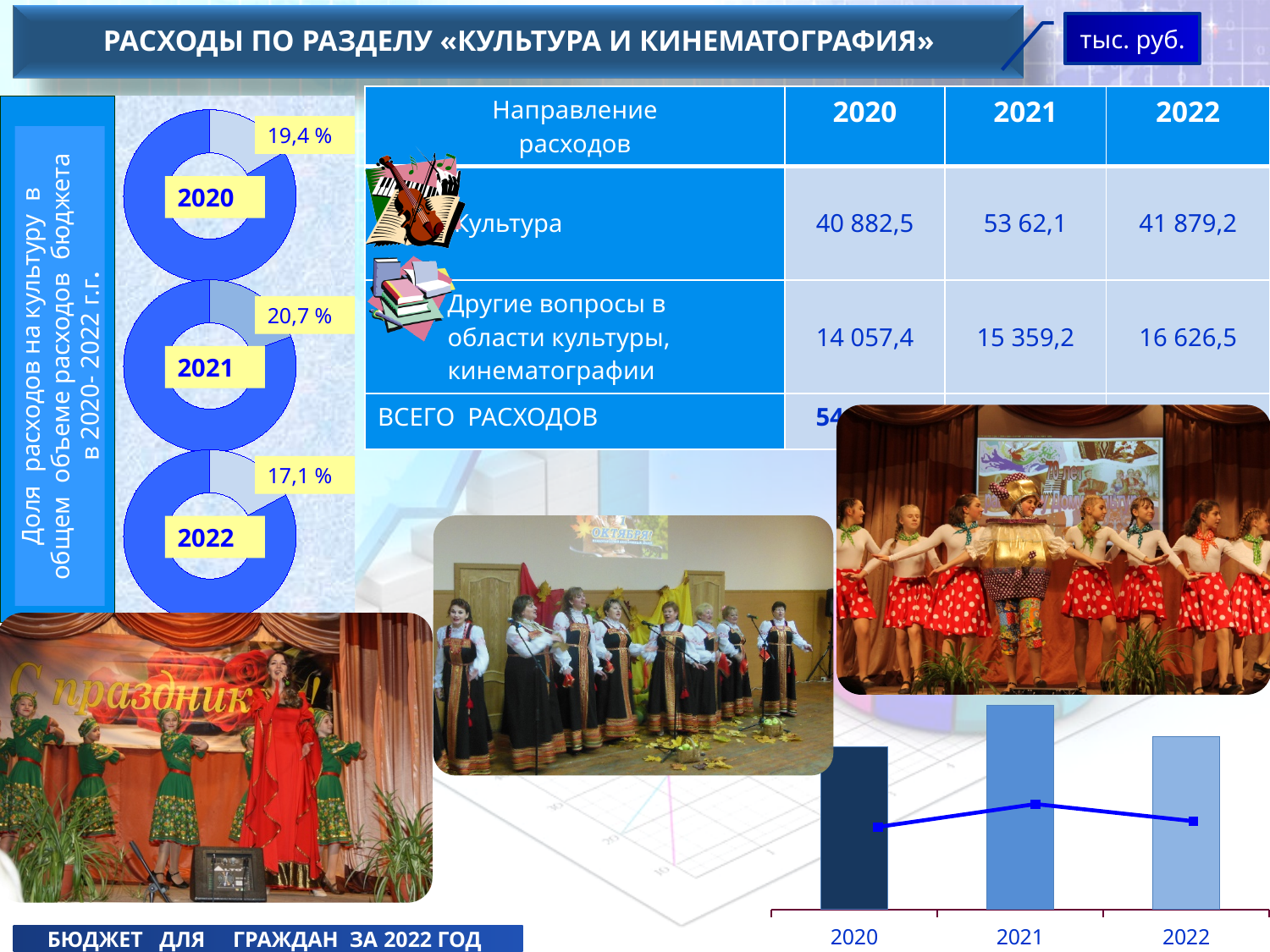
What kind of chart is shown in the bottom right corner of the slide? Bar chart combined with a line chart In the donut charts on the left, what share of total budget expenditure did culture expenses make up in 2022? 17,1 % In the donut charts on the left, which is larger: the share for 2020 or the share for 2022? 2020 In the donut charts on the left, what share of total budget expenditure did culture expenses make up in 2020? 19,4 % Among the donut charts on the left, which year has the highest share of culture expenses in the total budget? 2021 How many donut charts are shown on the left side of the slide? 3 In the donut charts on the left, by how many percentage points does the 2021 share exceed the 2020 share? 1,3 % Among the donut charts on the left, which year has the lowest share of culture expenses in the total budget? 2022 In the bar chart in the bottom right corner, which year has the tallest bar? 2021 In the donut charts on the left, by how many percentage points does the 2021 share exceed the 2022 share? 3,6 % In the donut charts on the left, what share of total budget expenditure did culture expenses make up in 2021? 20,7 % What kind of chart is used on the left side of the slide to show the share of culture expenses in the total budget? Donut (pie) chart